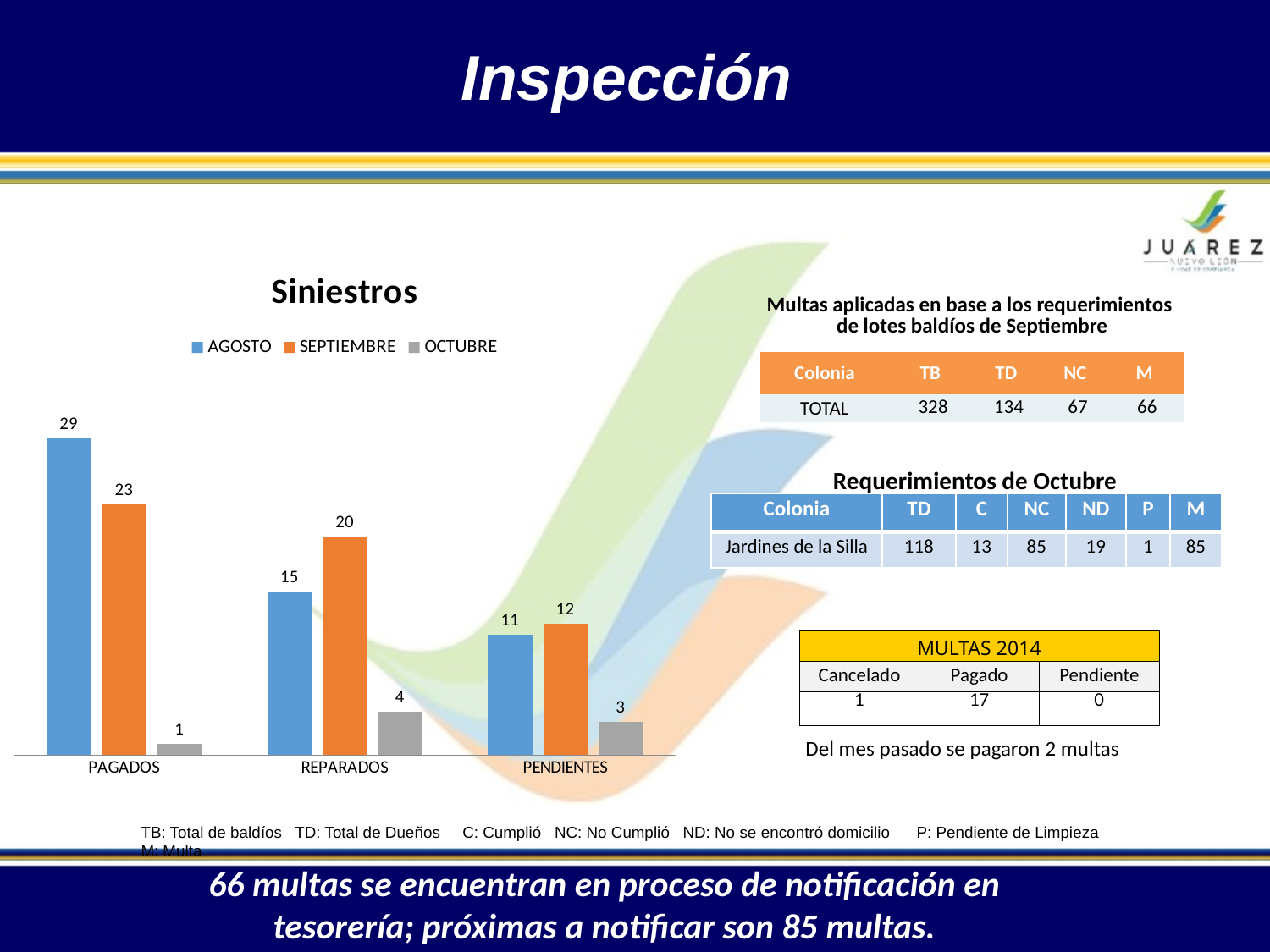
In the Siniestros chart, do the AGOSTO values rise or fall from PAGADOS to PENDIENTES? fall What kind of chart is the Siniestros chart? bar chart In the Siniestros chart, which category has the lowest OCTUBRE value? PAGADOS How many categories are shown on the x axis of the Siniestros chart? 3 In the Siniestros chart, which is larger for REPARADOS: the AGOSTO value or the SEPTIEMBRE value? SEPTIEMBRE In the Siniestros chart, what is the value for AGOSTO in the PAGADOS category? 29 In the Siniestros chart, what is the value for SEPTIEMBRE in the PENDIENTES category? 12 How many series does the legend of the Siniestros chart list? 3 In the Siniestros chart, which category has the highest AGOSTO value? PAGADOS What is the title of the chart on the slide? Siniestros In the Siniestros chart, what is the value for OCTUBRE in the REPARADOS category? 4 In the Siniestros chart, what is the difference between the AGOSTO and SEPTIEMBRE values for PAGADOS? 6